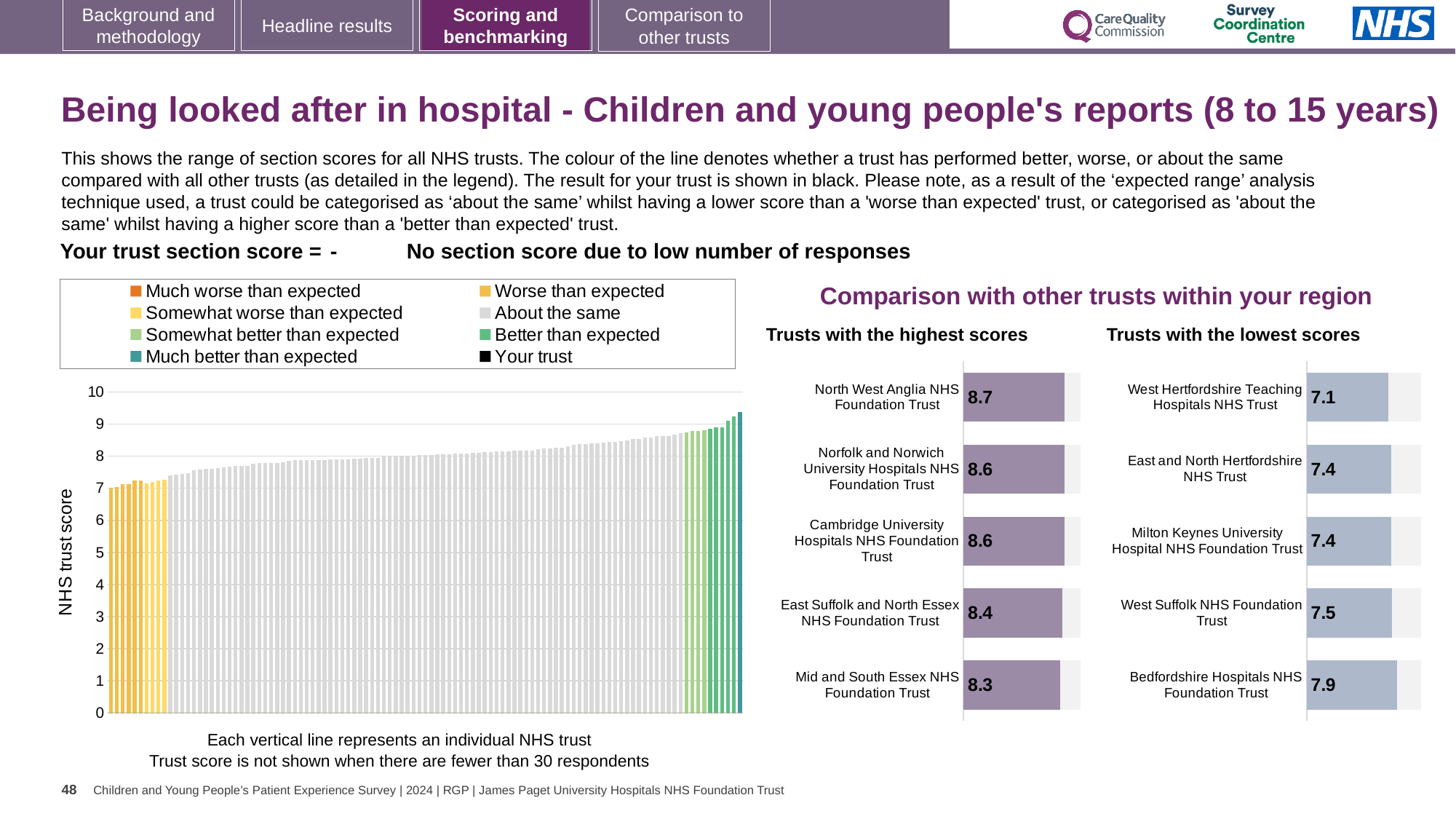
In the 'Trusts with the highest scores' chart, which trust has the lowest score? Mid and South Essex NHS Foundation Trust How many entries does the legend above the large 'NHS trust score' chart list? 8 In the 'Trusts with the lowest scores' chart, what is the score for West Hertfordshire Teaching Hospitals NHS Trust? 7.1 In the 'Trusts with the lowest scores' chart, which has the larger score: West Suffolk NHS Foundation Trust or Bedfordshire Hospitals NHS Foundation Trust? Bedfordshire Hospitals NHS Foundation Trust In the 'Trusts with the lowest scores' chart, which trust has the highest score? Bedfordshire Hospitals NHS Foundation Trust In the large 'NHS trust score' chart on the left, do the values rise or fall from left to right? Rise In the 'Trusts with the highest scores' chart, what is the score for North West Anglia NHS Foundation Trust? 8.7 In the large 'NHS trust score' chart on the left, is the value of the rightmost bar greater or less than 9? greater How many trusts are shown in the 'Trusts with the lowest scores' chart? 5 In the 'Trusts with the highest scores' chart, what is the difference between the scores of North West Anglia NHS Foundation Trust and East Suffolk and North Essex NHS Foundation Trust? 0.3 In the 'Trusts with the highest scores' chart, what is the score for Mid and South Essex NHS Foundation Trust? 8.3 What kind of chart is the large 'NHS trust score' chart on the left of the slide? Bar chart